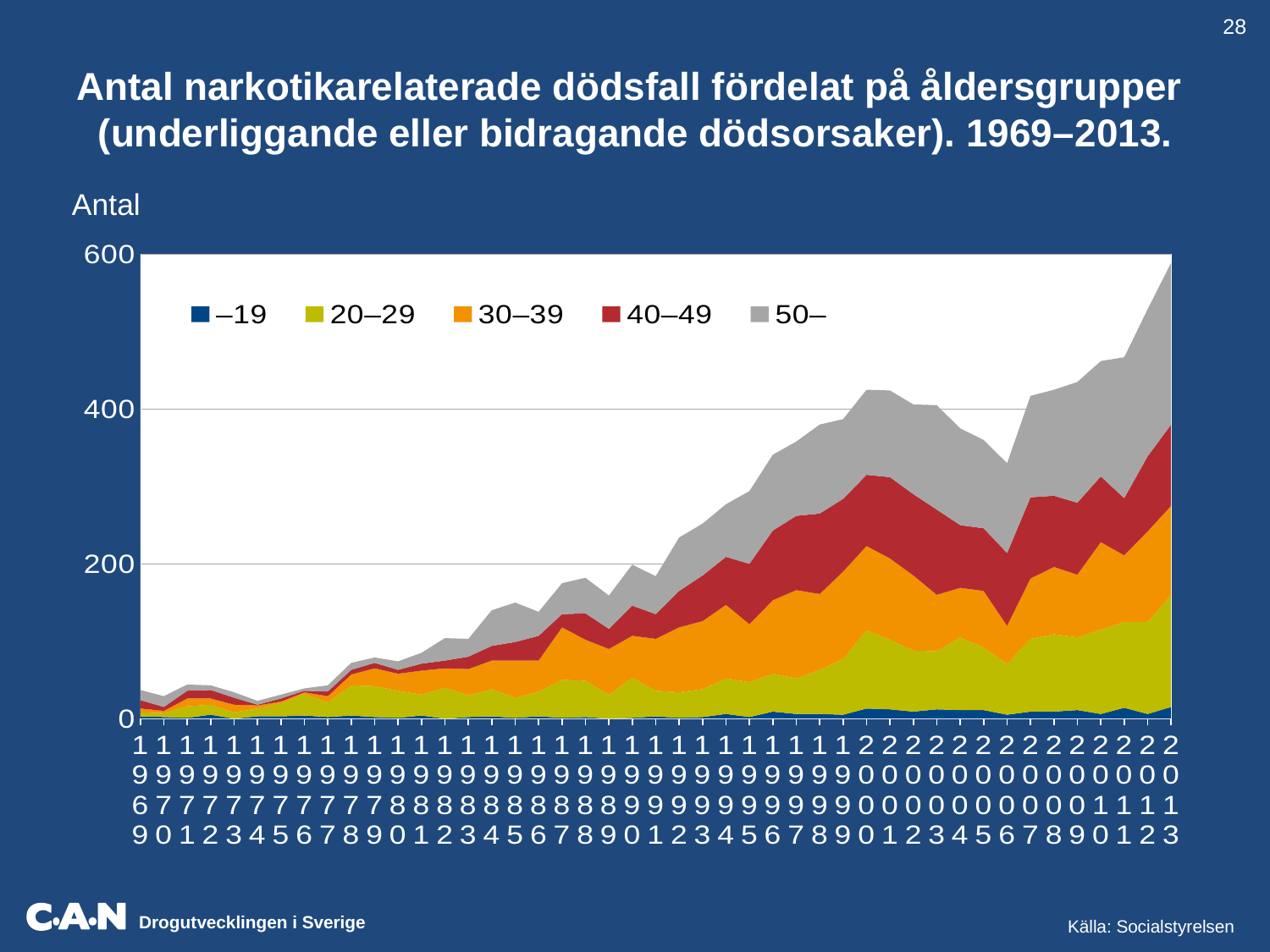
Is the total number of deaths in 2013 greater or less than 400? greater Which colour represents the 50– age group? grey Is the total number of deaths in 1985 greater or less than 200? less Which year has the larger total number of deaths, 1980 or 2013? 2013 Is the total number of deaths in 1969 greater or less than 200? less What is the label on the y axis? Antal Which year has the highest total number of deaths? 2013 How many age-group series does the legend list? 5 Do the total number of deaths generally rise or fall from 1969 to 2013? rise What kind of chart is shown on the slide? stacked area chart How many years are plotted along the x axis? 45